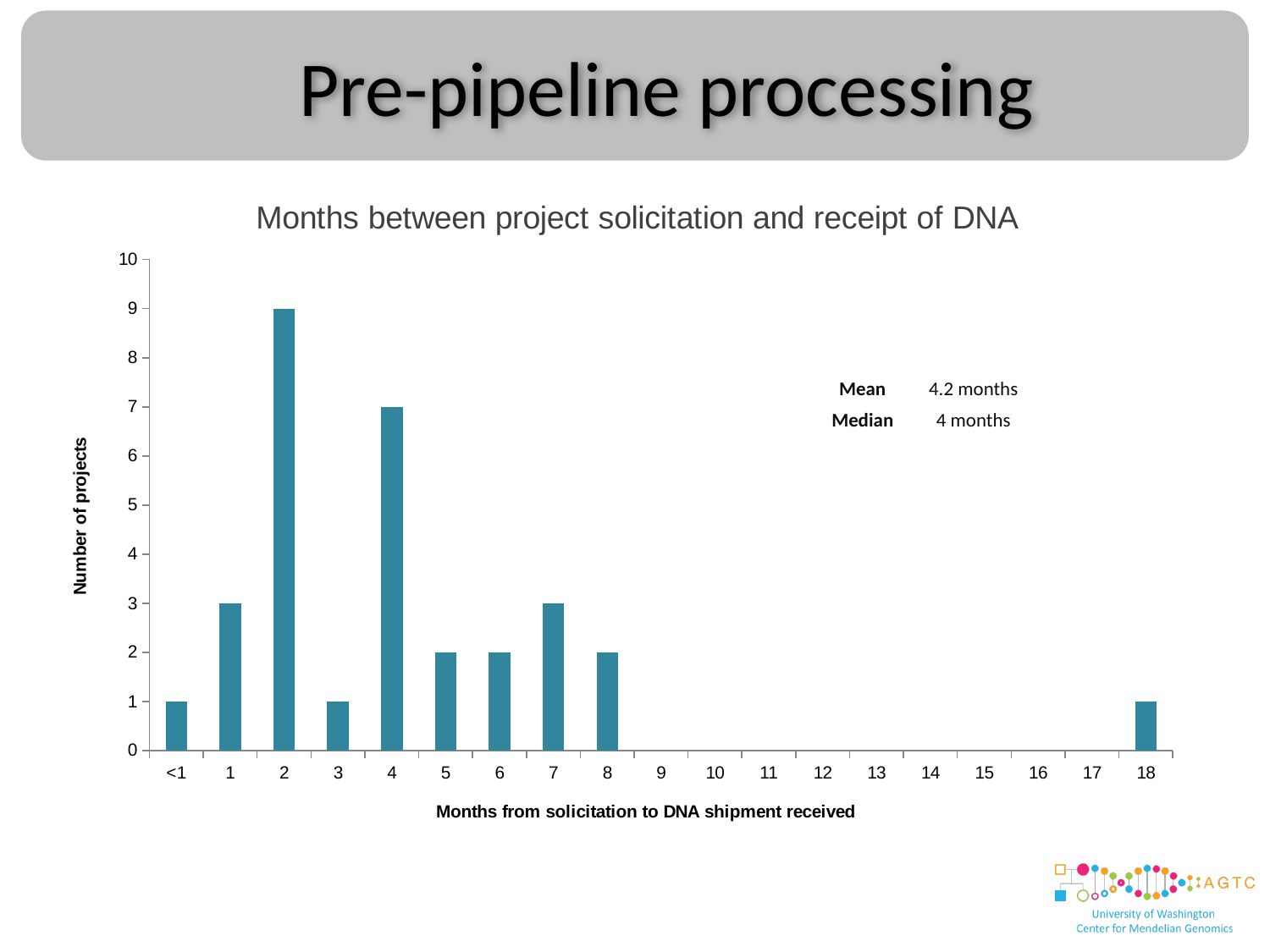
What is the title of the chart? Months between project solicitation and receipt of DNA What is the label of the y axis? Number of projects Is the number of projects for the 2-month category greater or less than 5? greater Which has more projects, the 1-month category or the 5-month category? 1-month How many month categories are labelled on the x axis? 19 What is the difference in number of projects between the 2-month and 4-month categories? 2 How many projects had 4 months between solicitation and DNA shipment received? 7 How many projects had 2 months between solicitation and DNA shipment received? 9 How many projects are shown for the 18-month category? 1 Which month category has the highest number of projects? 2 How many projects had 7 months between solicitation and DNA shipment received? 3 What type of chart is shown on the slide? bar chart